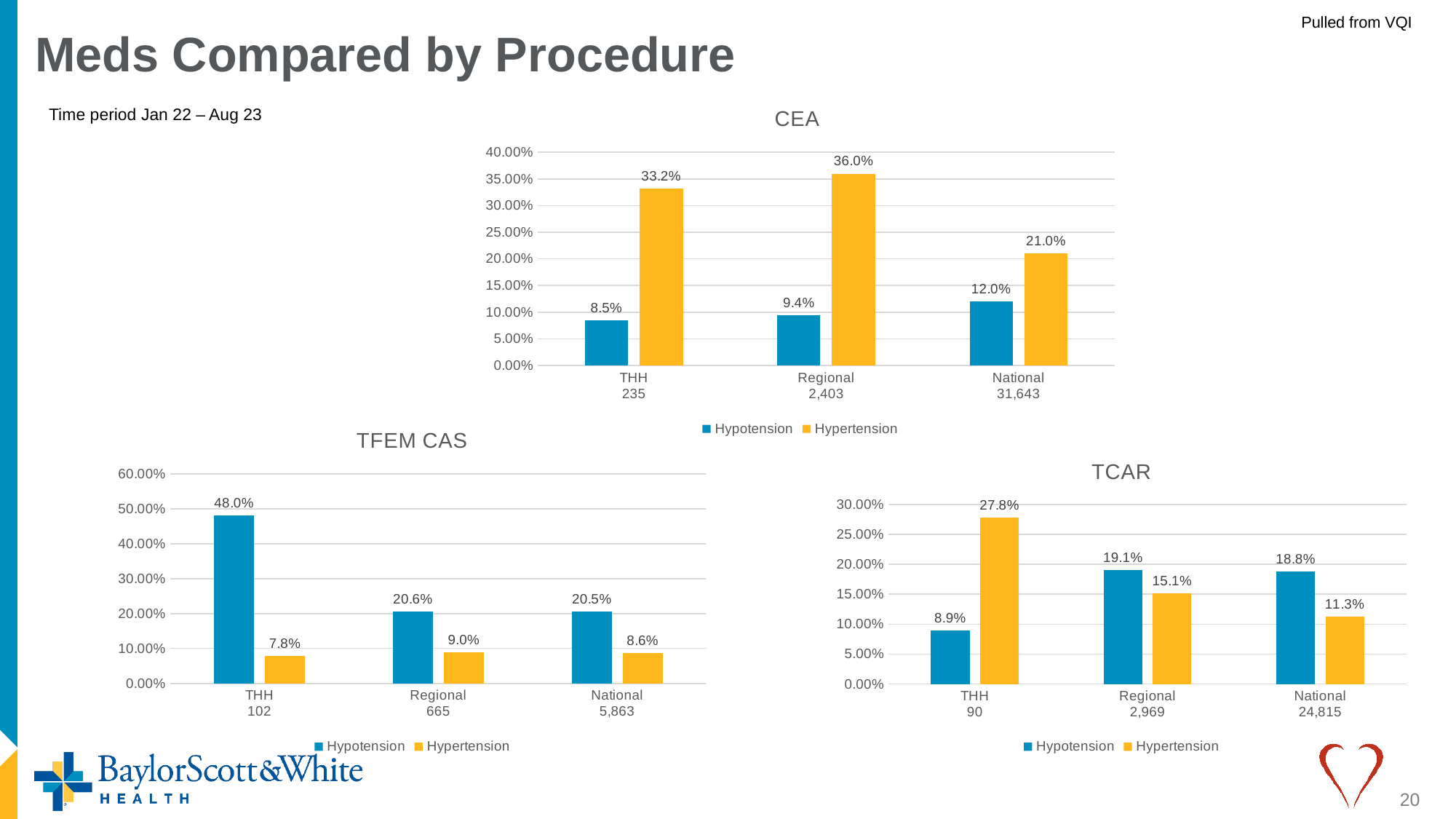
In the TFEM CAS chart, what is the difference between the Hypotension and Hypertension values for THH? 40.2% How many categories are shown on the x axis of the TCAR chart? 3 In the CEA chart, which category has the highest Hypertension value? Regional In the TCAR chart, which is larger for Regional: Hypotension or Hypertension? Hypotension In the CEA chart, what is the Hypotension value for THH? 8.5% In the CEA chart, what is the Hypertension value for Regional? 36.0% What kind of chart is the CEA chart? Bar chart In the TCAR chart, which category has the lowest Hypotension value? THH In the CEA chart, is the Hypertension value for National greater or less than 15.00%? greater In the TFEM CAS chart, what is the Hypotension value for THH? 48.0% How many series does the legend of the TFEM CAS chart list? 2 In the TCAR chart, what is the Hypertension value for National? 11.3%